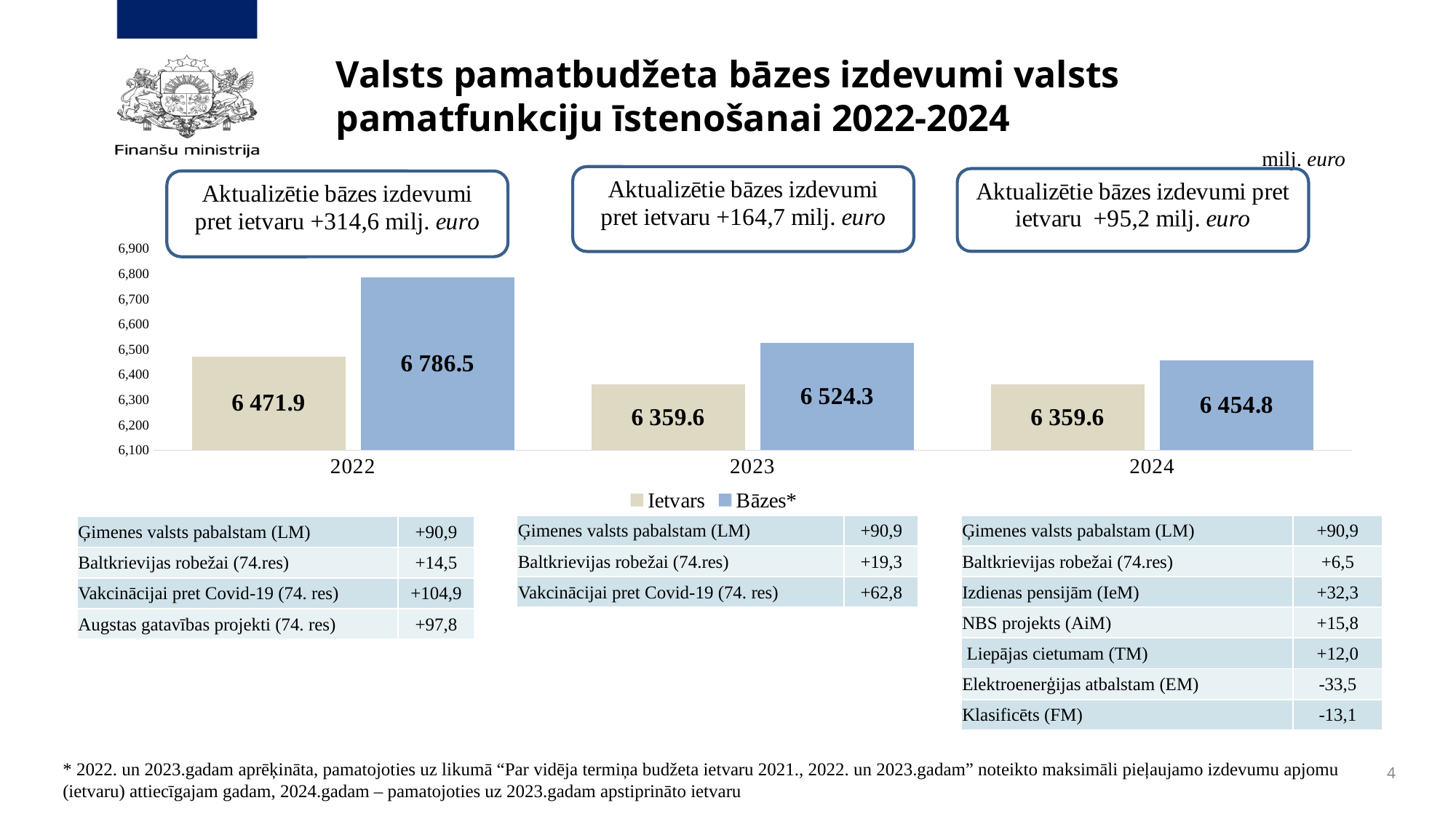
What is the Ietvars value for 2023? 6 359.6 What is the difference between the Bāzes* and Ietvars values for 2023? 164.7 What is the difference between the Bāzes* and Ietvars values for 2024? 95.2 Which year has the lowest Bāzes* value? 2024 What is the Ietvars value for 2022? 6 471.9 What is the Bāzes* value for 2024? 6 454.8 Which year has the highest Bāzes* value? 2022 Do the Bāzes* values rise or fall from 2022 to 2024? Fall Which is larger in 2022, the Ietvars value or the Bāzes* value? Bāzes* How many series does the legend list? 2 What is the Bāzes* value for 2022? 6 786.5 What kind of chart is shown on the slide? Bar chart